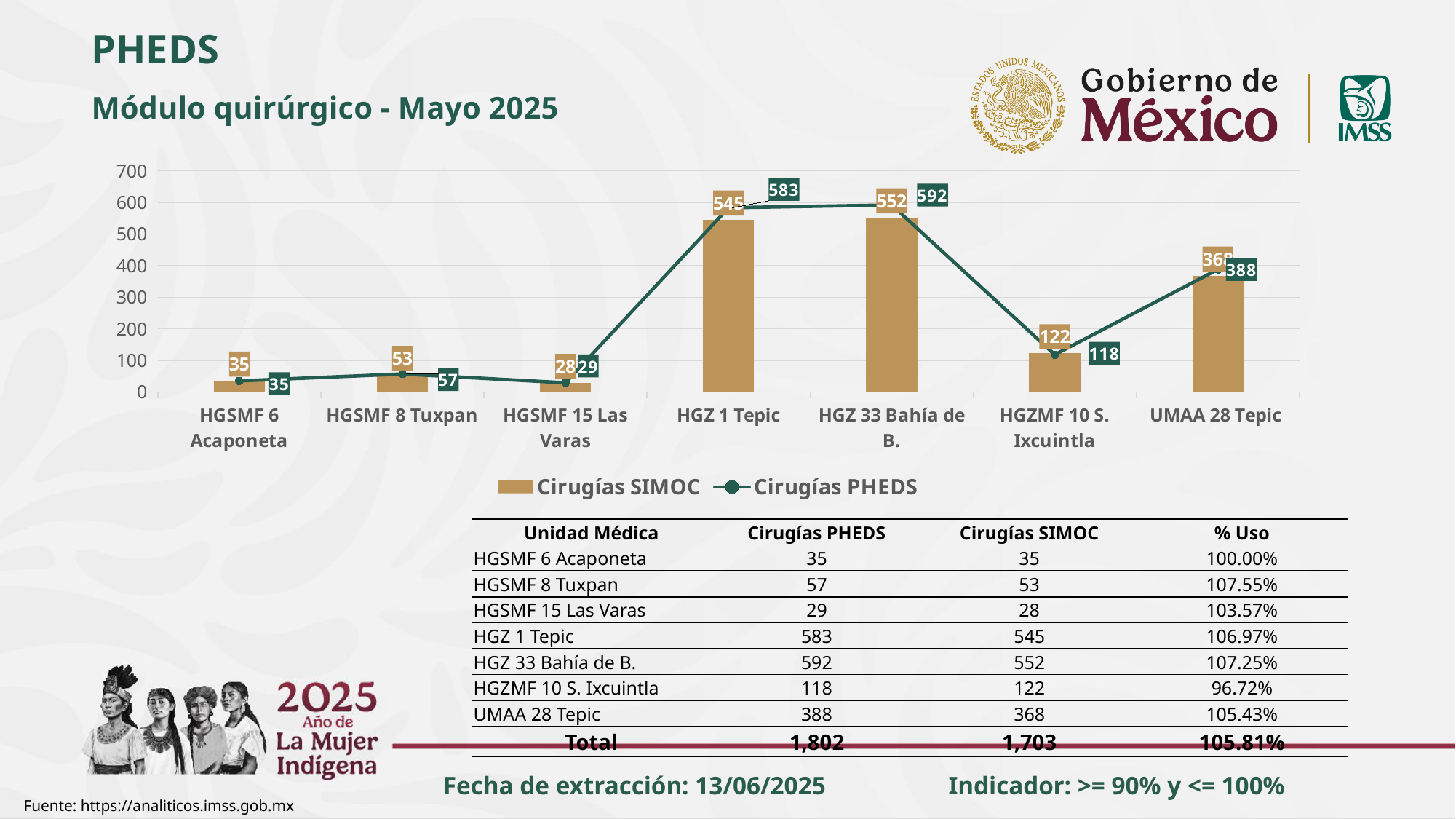
How many series does the chart legend list? 2 Which unit has the lowest value for Cirugías PHEDS? HGSMF 15 Las Varas What is the value of Cirugías PHEDS for HGZMF 10 S. Ixcuintla? 118 Which series is drawn as a line in the chart? Cirugías PHEDS For HGZMF 10 S. Ixcuintla, which is larger: Cirugías SIMOC or Cirugías PHEDS? Cirugías SIMOC What is the value of Cirugías PHEDS for HGZ 33 Bahía de B.? 592 What is the difference between Cirugías PHEDS and Cirugías SIMOC for UMAA 28 Tepic? 20 Is the Cirugías SIMOC value for UMAA 28 Tepic greater or less than 300? greater What kind of chart is shown on the slide? A combined bar and line chart Which unit has the highest value for Cirugías SIMOC? HGZ 33 Bahía de B. How many medical units are shown on the x axis of the chart? 7 What is the value of Cirugías SIMOC for HGZ 1 Tepic? 545